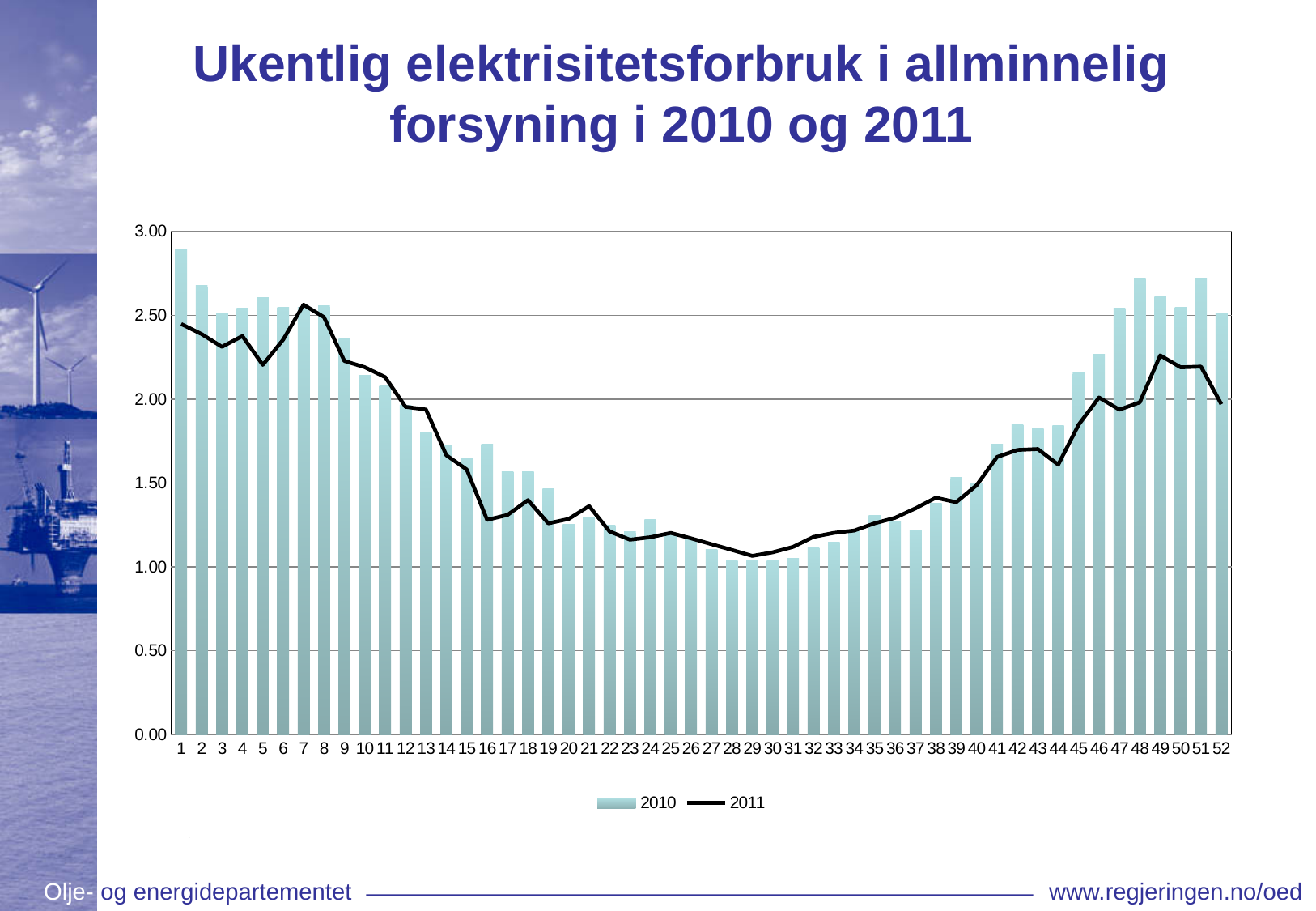
How many series does the legend list? 2 In which week does the 2011 line reach its highest value? Week 7 What kind of chart is shown on the slide? A combined bar and line chart Is the 2011 value for week 49 greater or less than 2.00? greater Is the 2011 value for week 16 greater or less than 1.50? less Do the 2010 values rise or fall from week 1 to week 29? fall Is the 2010 value for week 29 greater or less than 1.50? less In week 1, which series has the larger value, 2010 or 2011? 2010 In which week is the 2010 bar highest? Week 1 How many weeks are shown along the x axis? 52 Which series are listed in the legend? 2010 and 2011